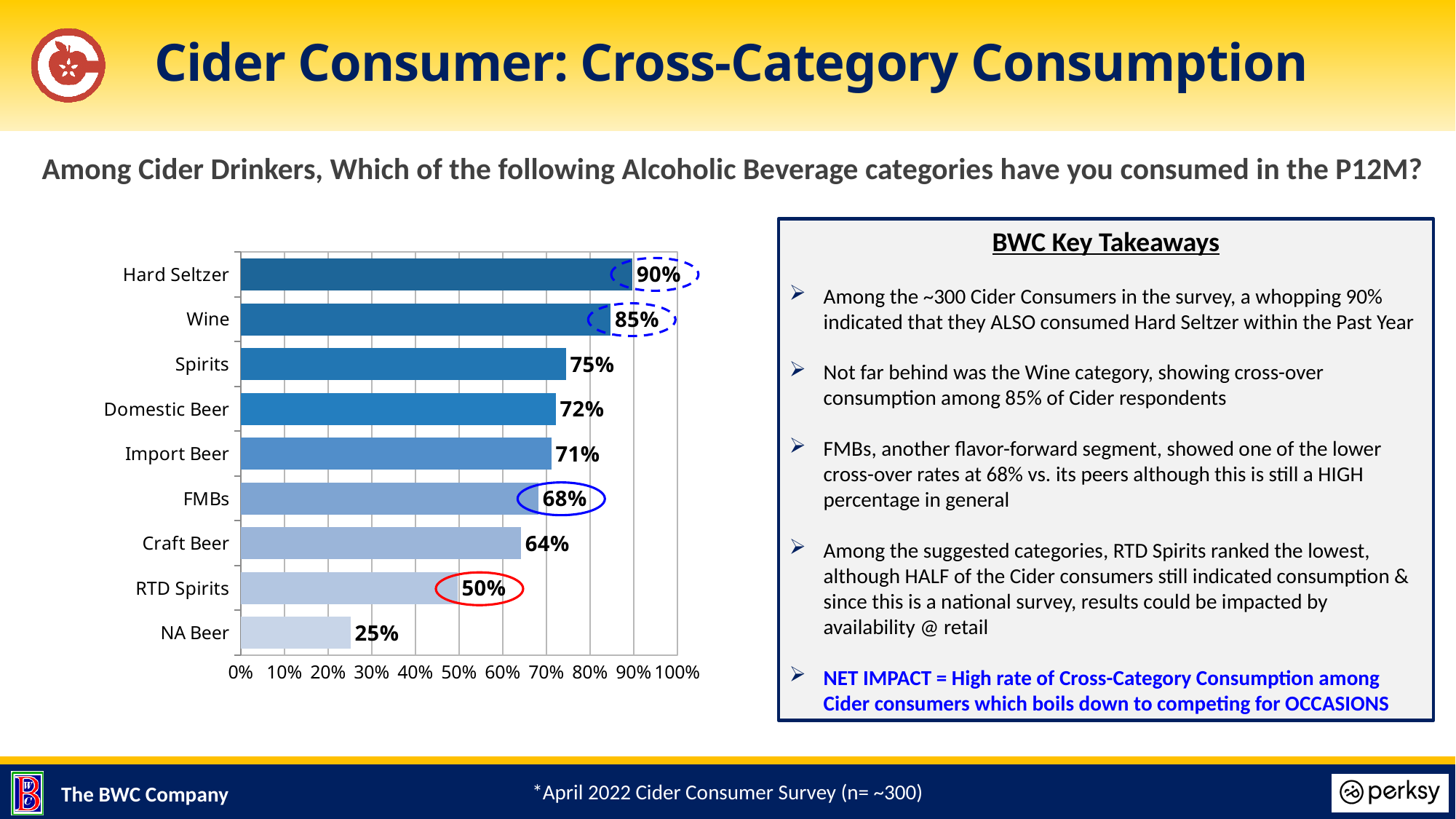
What is the value shown for Import Beer? 71% What kind of chart is shown on the slide? bar chart Which category's data label is circled in red on the chart? RTD Spirits Is the value for Craft Beer greater or less than 70%? less What is the value shown for Craft Beer? 64% What is the difference between the values for Wine and Spirits? 10% What percentage of cider drinkers consumed Hard Seltzer in the P12M? 90% What is the difference between the values for RTD Spirits and NA Beer? 25% How many categories are shown on the chart? 9 Which category has the lowest value on the chart? NA Beer Which category has the highest value on the chart? Hard Seltzer Which is larger, the value for Domestic Beer or the value for FMBs? Domestic Beer